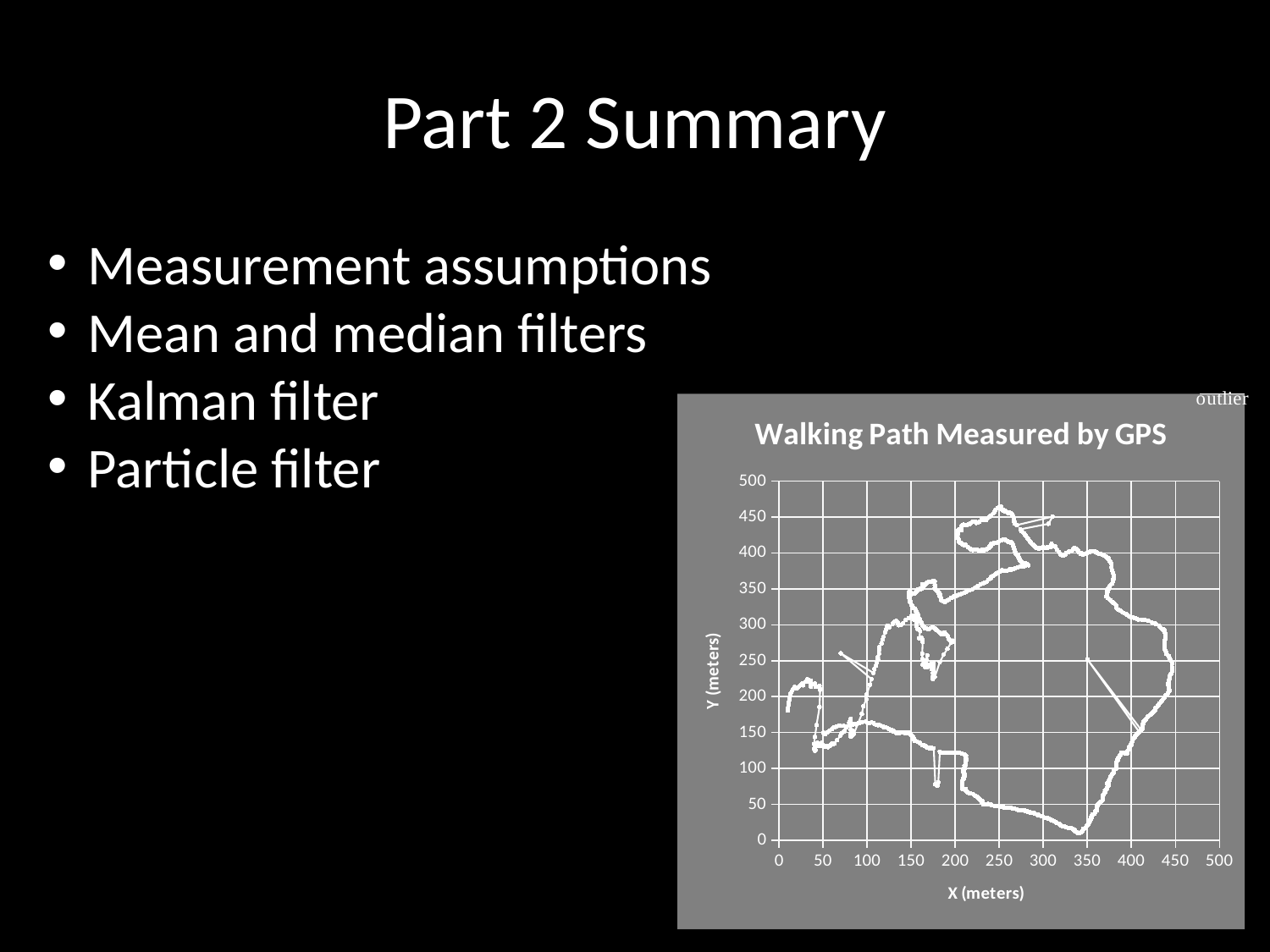
Is the lowest Y value reached by the walking path greater or less than 50? less Is the smallest X value reached by the walking path greater or less than 50? less Is the largest X value reached by the walking path greater or less than 400? greater What kind of chart is shown on the slide? scatter (line) chart What is the highest tick value shown on the X axis of the chart? 500 What is the label of the vertical axis of the chart? Y (meters) What is the title of the chart on the slide? Walking Path Measured by GPS